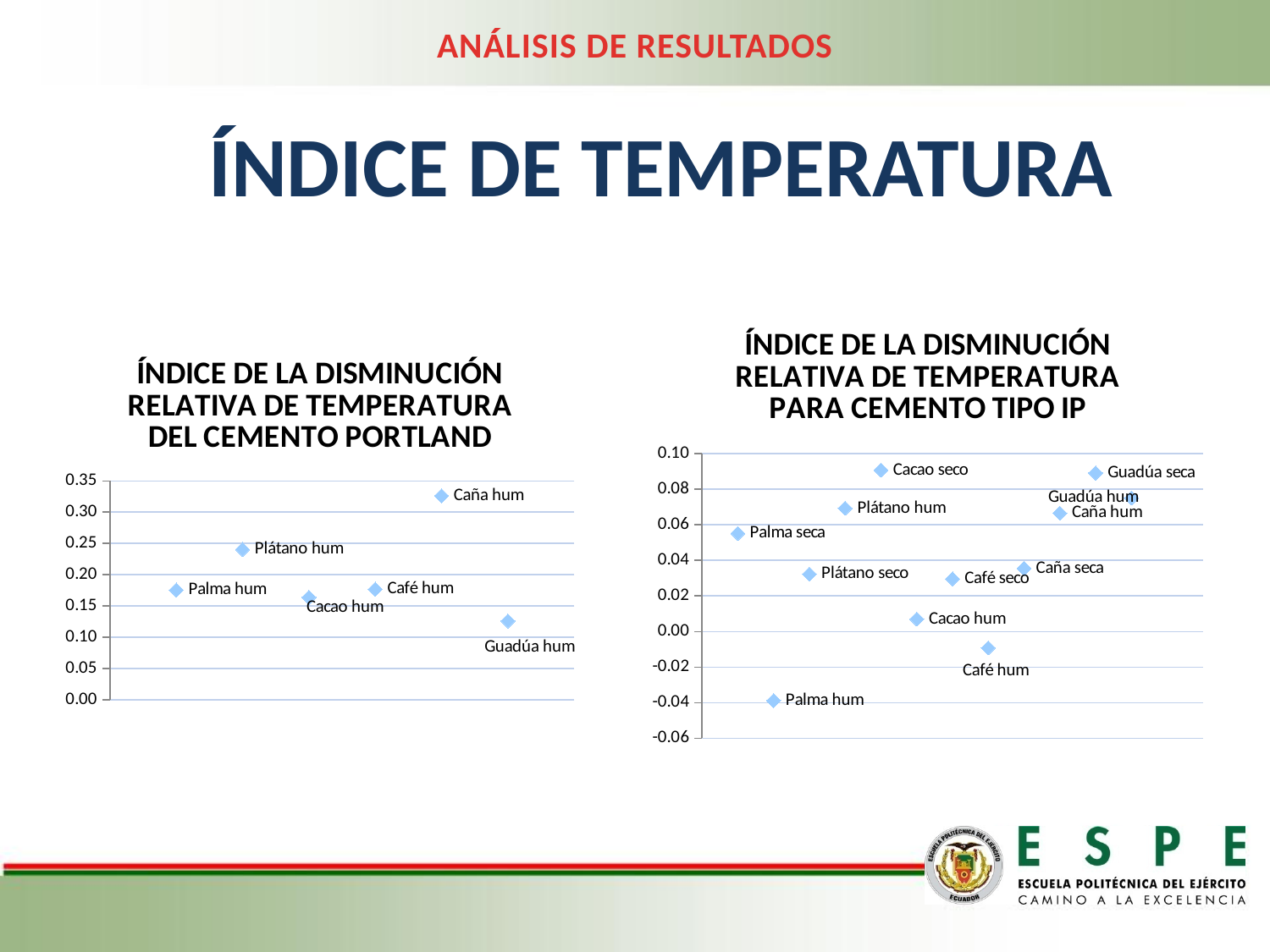
In the left chart (cemento Portland), how many data points are plotted? 6 In the right chart (cemento tipo IP), which material has the lowest index value? Palma hum In the right chart (cemento tipo IP), how many data points are plotted? 12 In the right chart (cemento tipo IP), is the value for Palma hum greater or less than 0.00? less In the left chart (cemento Portland), which material has the lowest index value? Guadúa hum What kind of chart is the left chart, 'Índice de la disminución relativa de temperatura del cemento Portland'? scatter chart In the left chart (cemento Portland), which has the larger value, Caña hum or Plátano hum? Caña hum In the right chart (cemento tipo IP), which has the larger value, Palma seca or Caña seca? Palma seca In the left chart (cemento Portland), which material has the highest index value? Caña hum In the right chart (cemento tipo IP), is the value for Cacao seco greater or less than 0.08? greater In the left chart (cemento Portland), is the value for Guadúa hum greater or less than 0.15? less